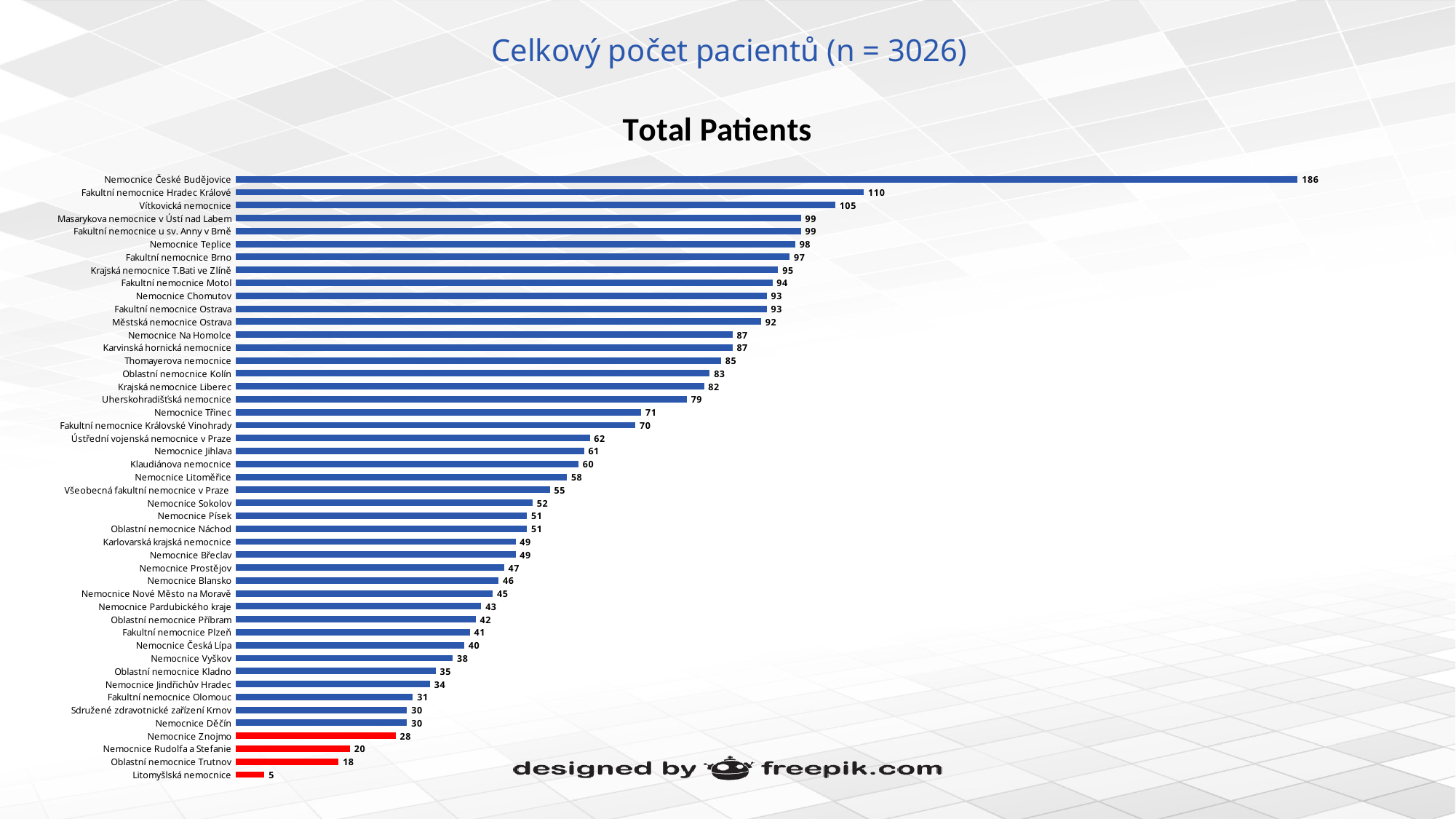
How many hospitals are shown in the chart? 47 Which hospital has the lowest number of total patients? Litomyšlská nemocnice What kind of chart is shown on the slide? bar chart What is the difference between the values for Nemocnice Třinec and Nemocnice Jihlava? 10 How many bars are coloured red in the chart? 4 What is the value for Nemocnice Znojmo? 28 What is the value for Fakultní nemocnice Motol? 94 What is the difference between the values for Nemocnice České Budějovice and Fakultní nemocnice Hradec Králové? 76 Which is larger, the value for Oblastní nemocnice Trutnov or the value for Nemocnice Rudolfa a Stefanie? Nemocnice Rudolfa a Stefanie Which is larger, the value for Vítkovická nemocnice or the value for Nemocnice Teplice? Vítkovická nemocnice Which hospital has the highest number of total patients? Nemocnice České Budějovice What is the value for Nemocnice České Budějovice? 186